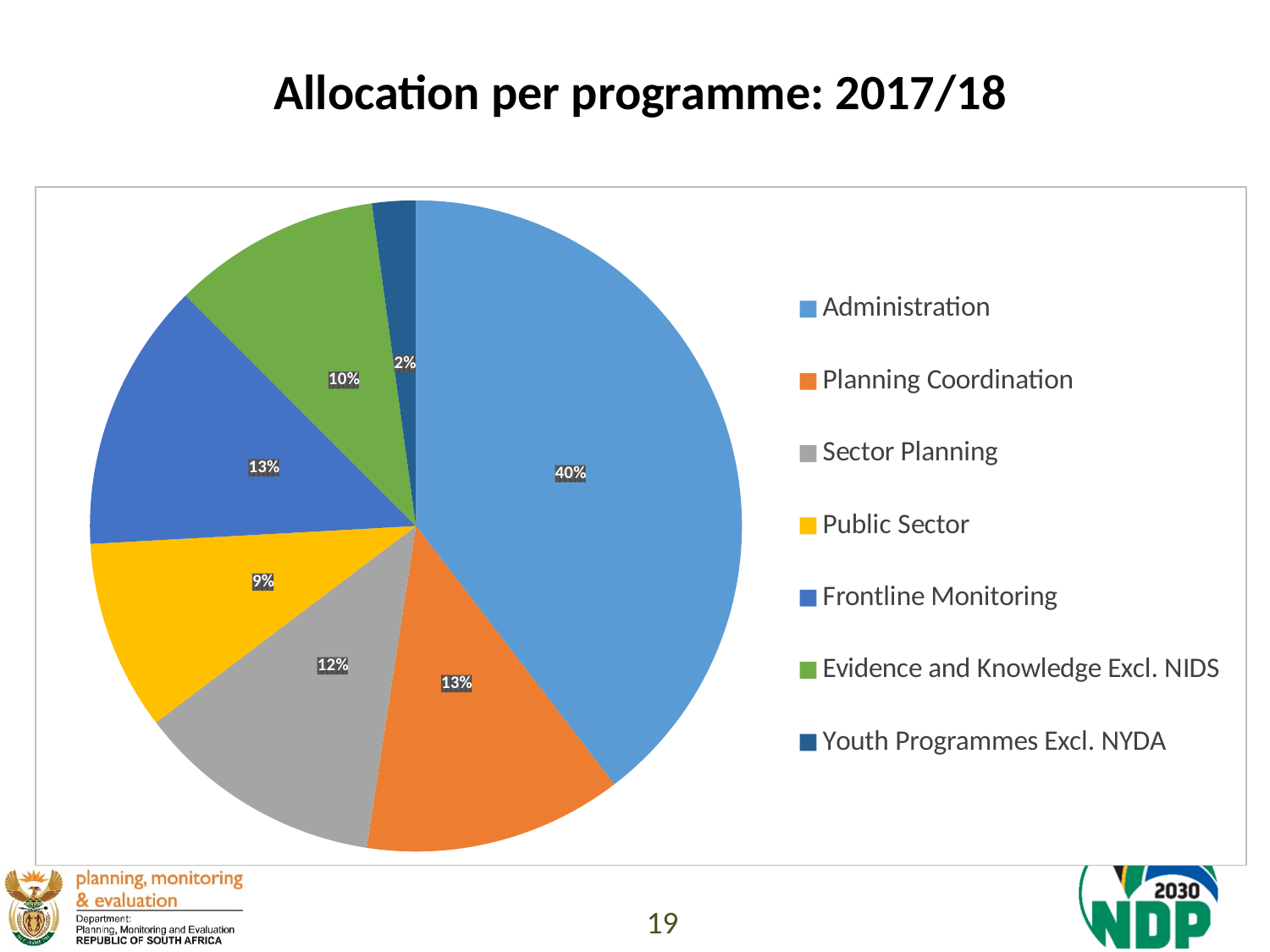
What is the difference in percentage points between Administration and Planning Coordination? 27 What percentage of the allocation is for Public Sector? 9% What is the title of the chart? Allocation per programme: 2017/18 How many programmes are shown in the pie chart? 7 What percentage is allocated to Sector Planning? 12% What type of chart is shown on the slide? Pie chart What share of the allocation goes to Administration? 40% Which has a larger share, Evidence and Knowledge Excl. NIDS or Youth Programmes Excl. NYDA? Evidence and Knowledge Excl. NIDS Which has a larger share, Sector Planning or Public Sector? Sector Planning Which programme receives the largest share of the allocation? Administration What share does Evidence and Knowledge Excl. NIDS receive? 10% Which programme receives the smallest share of the allocation? Youth Programmes Excl. NYDA